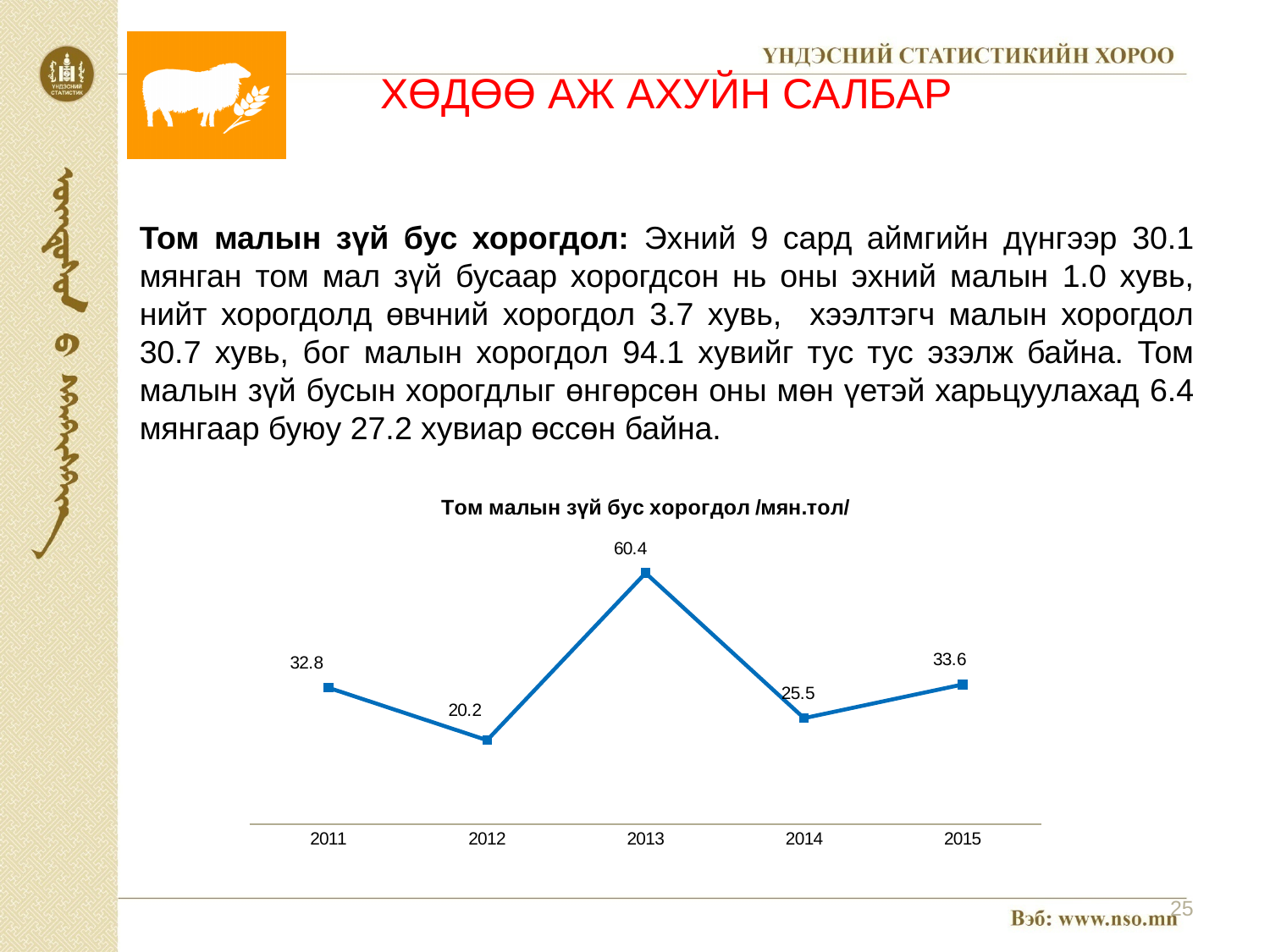
Does the value rise or fall from 2013 to 2014? Fall How many years are plotted in the chart? 5 What is the title of the chart? Том малын зүй бус хорогдол /мян.тол/ What is the value for 2013 in the chart? 60.4 What kind of chart is shown on the slide? Line chart What is the value for 2011 in the chart? 32.8 What is the difference between the values for 2015 and 2014? 8.1 Which year has the lowest value in the chart? 2012 Which is larger, the value for 2011 or the value for 2014? 2011 What is the value for 2015 in the chart? 33.6 What is the difference between the values for 2013 and 2012? 40.2 Which year has the highest value in the chart? 2013